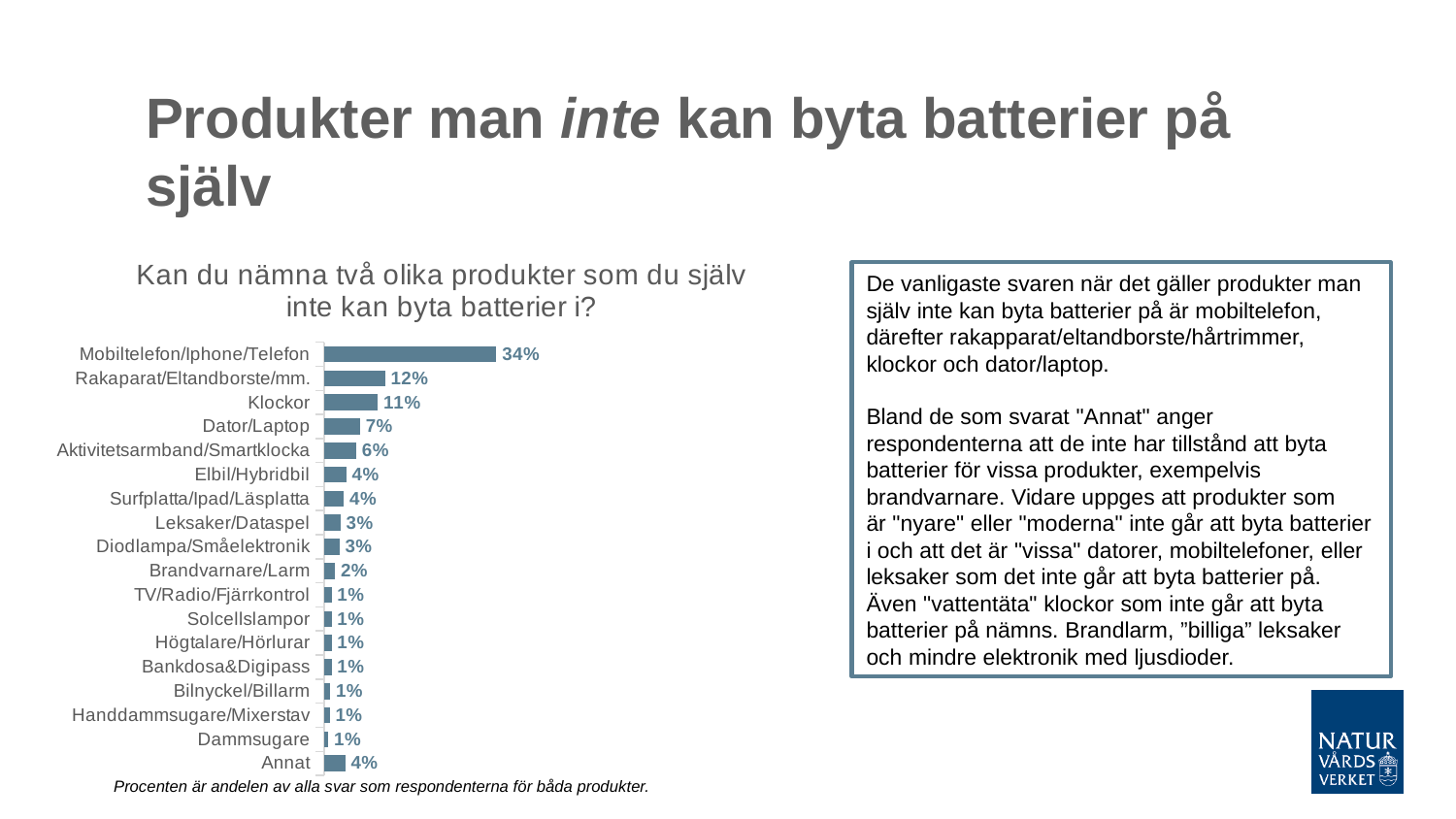
What is the title of the chart? Kan du nämna två olika produkter som du själv inte kan byta batterier i? What kind of chart is shown on the slide? Bar chart What is the value for Mobiltelefon/Iphone/Telefon? 34% What is the value for Brandvarnare/Larm? 2% Which category has the highest value? Mobiltelefon/Iphone/Telefon Which is larger, Aktivitetsarmband/Smartklocka or Leksaker/Dataspel? Aktivitetsarmband/Smartklocka What is the value for Klockor? 11% What is the value for Annat? 4% How many categories are shown in the chart? 18 What is the value for Dator/Laptop? 7% What is the difference between Mobiltelefon/Iphone/Telefon and Rakaparat/Eltandborste/mm.? 22% What is the difference between Klockor and Dator/Laptop? 4%